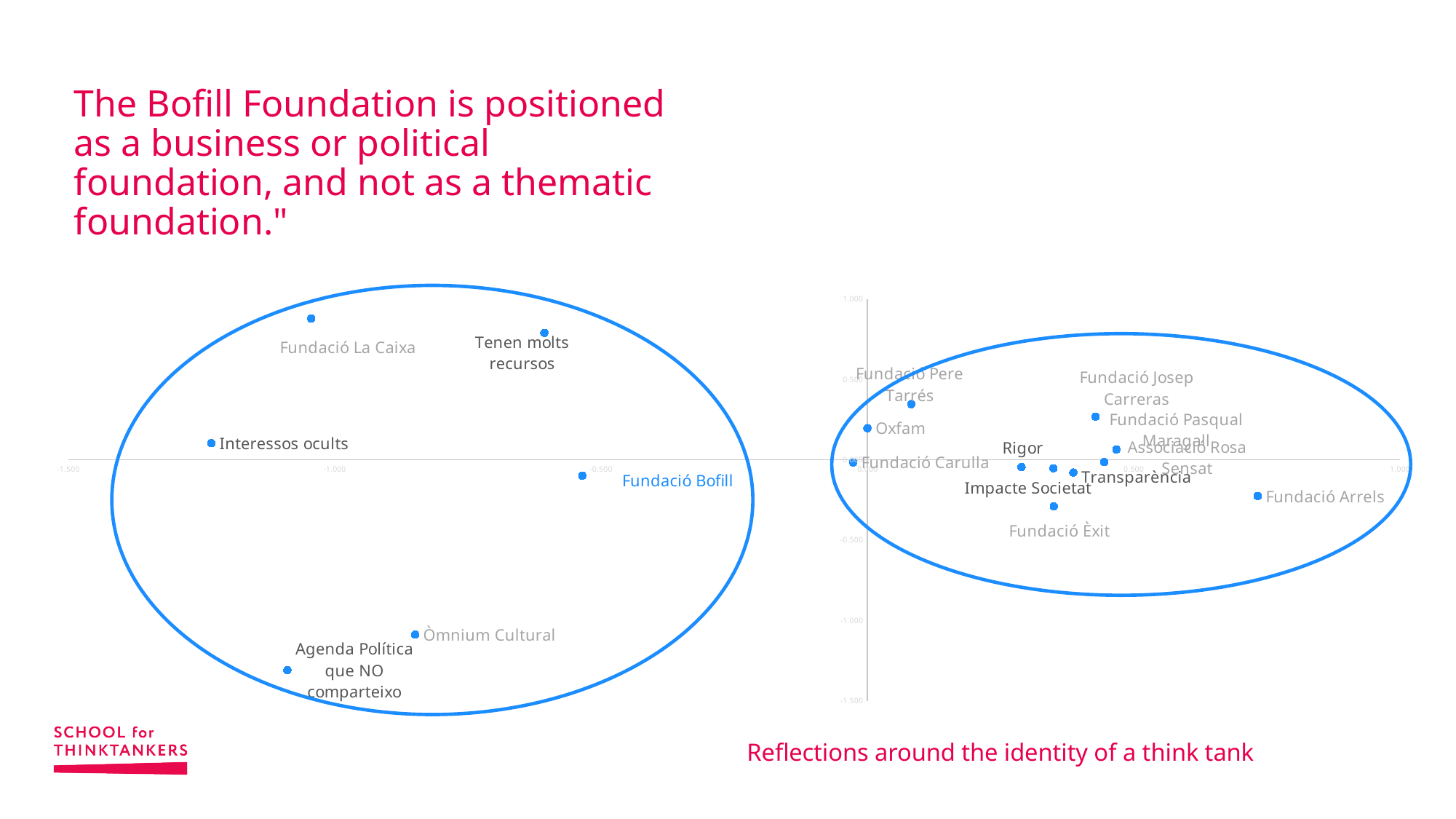
What kind of chart is shown on the slide? scatter plot How many labelled points are plotted on the chart? 17 How many blue ellipses are drawn around groups of points on the chart? 2 Is the horizontal-axis value for Fundació Arrels greater or less than 0.500? greater Which point label on the chart is written in blue? Fundació Bofill Is the vertical-axis value for Fundació Èxit greater or less than 0.000? less Which labelled point lies furthest to the left on the chart? Interessos ocults Which labelled point lies furthest to the right on the chart? Fundació Arrels Is the horizontal-axis value for Interessos ocults greater or less than -1.000? less Which labelled point is lowest on the vertical axis? Agenda Política que NO comparteixo Which has the larger horizontal-axis value, Fundació Bofill or Fundació La Caixa? Fundació Bofill